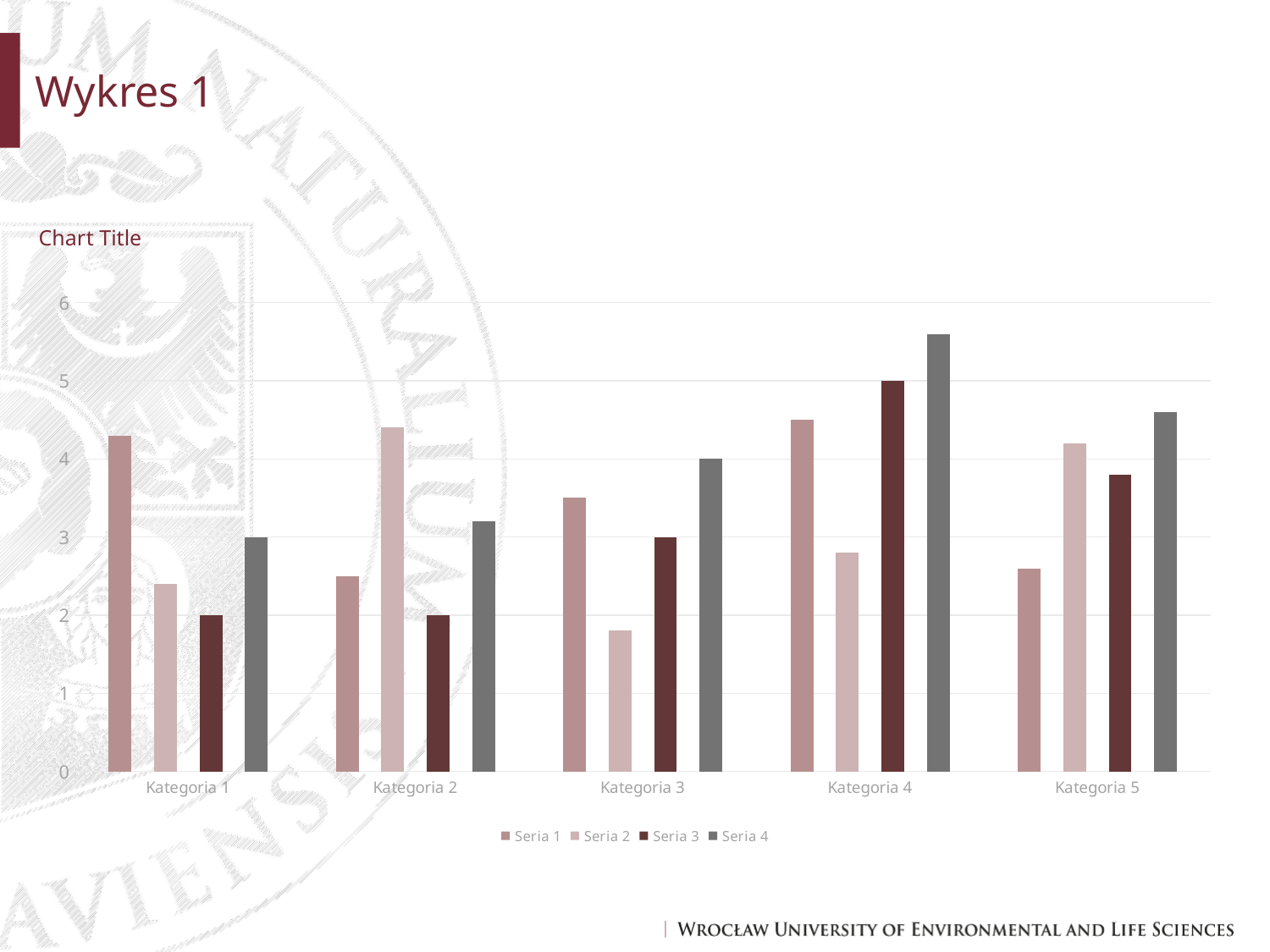
What kind of chart is shown on the slide? bar chart What is the value of Seria 3 for Kategoria 4? 5 What is the value of Seria 4 for Kategoria 1? 3 Is the value of Seria 2 for Kategoria 3 greater or less than 2? less Is the value of Seria 4 for Kategoria 4 greater or less than 5? greater What is the value of Seria 3 for Kategoria 1? 2 How many categories are shown on the x axis? 5 What is the value of Seria 4 for Kategoria 3? 4 In which category does Seria 4 reach its highest value? Kategoria 4 What is the difference between Seria 4 and Seria 3 for Kategoria 1? 1 How many series does the legend list? 4 What title is printed above the chart? Chart Title